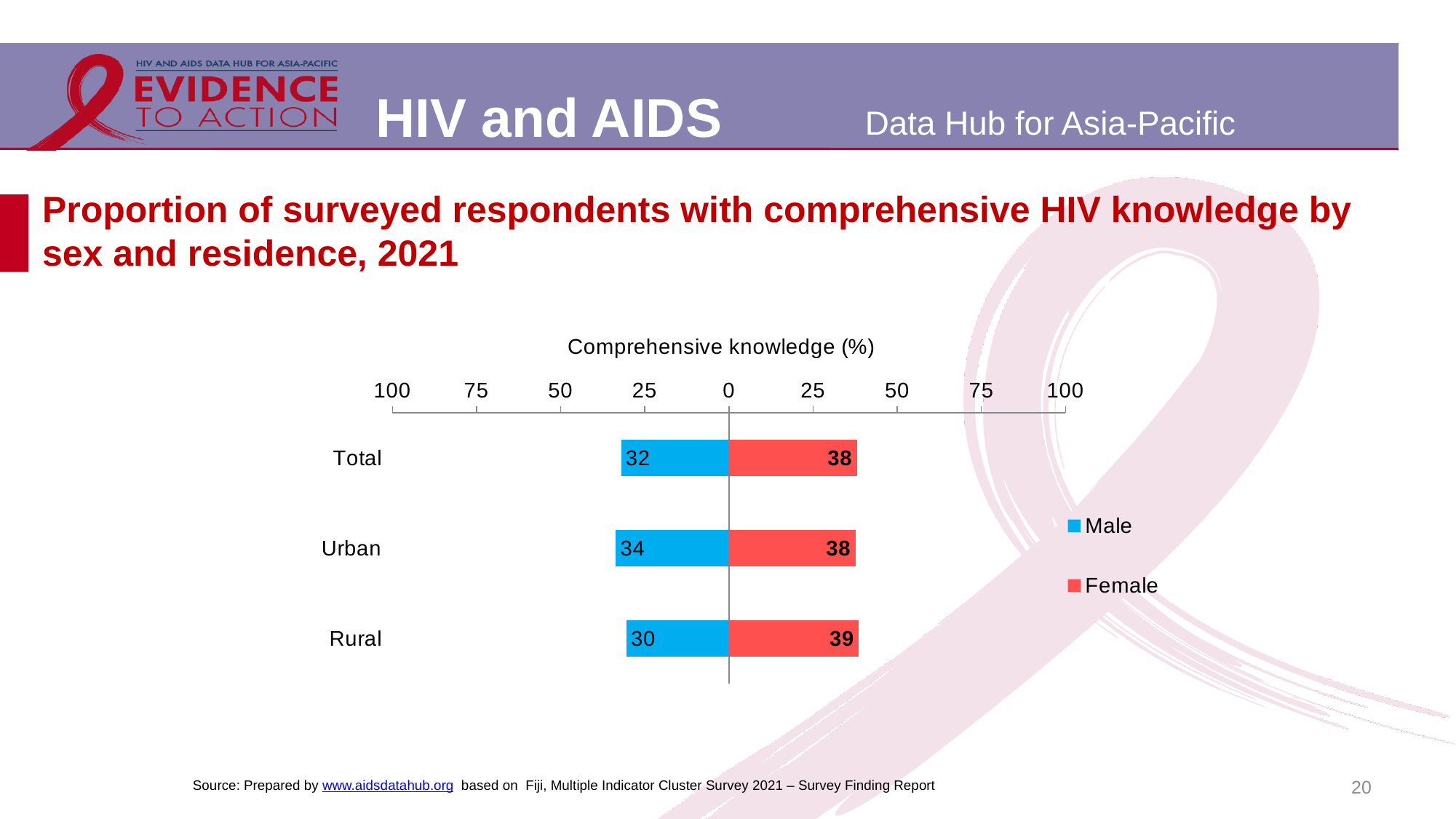
What kind of chart is shown on the slide? bar chart Which residence category has the lowest Male value? Rural What is the Female value for Urban? 38 What is the Female value for Rural? 39 How many series does the legend list? 2 Is the Male value for Rural greater or less than 50? less How many categories are shown on the chart? 3 Which residence category has the highest Male value? Urban What is the Male value for Total? 32 What is the difference between the Female and Male values for Rural? 9 Which is larger for Total, the Male value or the Female value? Female What is the Male value for Urban? 34